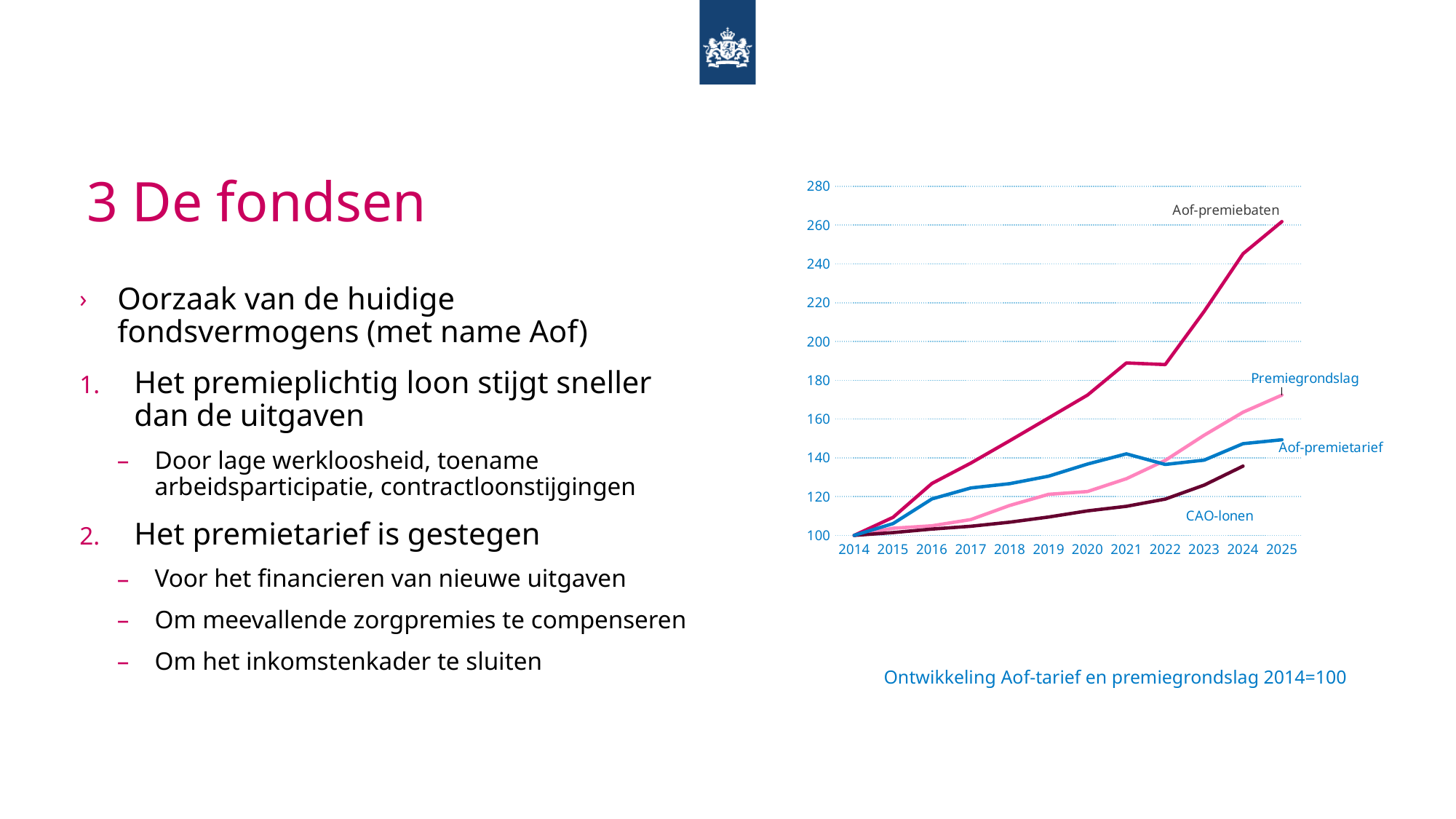
How many years are shown on the x axis of the chart? 12 What is the title of the chart? Ontwikkeling Aof-tarief en premiegrondslag 2014=100 Does the Aof-premiebaten series rise or fall from 2014 to 2025? rise In 2025, which is larger: Premiegrondslag or Aof-premietarief? Premiegrondslag Is the value for Aof-premiebaten in 2022 greater or less than 200? less What is the value of Aof-premiebaten in 2014? 100 Is the value for Aof-premiebaten in 2025 greater or less than 240? greater Is the value for Aof-premietarief in 2025 greater or less than 160? less Which series has the lowest value in 2024? CAO-lonen What kind of chart is shown on the slide? line chart How many series are plotted in the chart? 4 Which series has the highest value in 2025? Aof-premiebaten